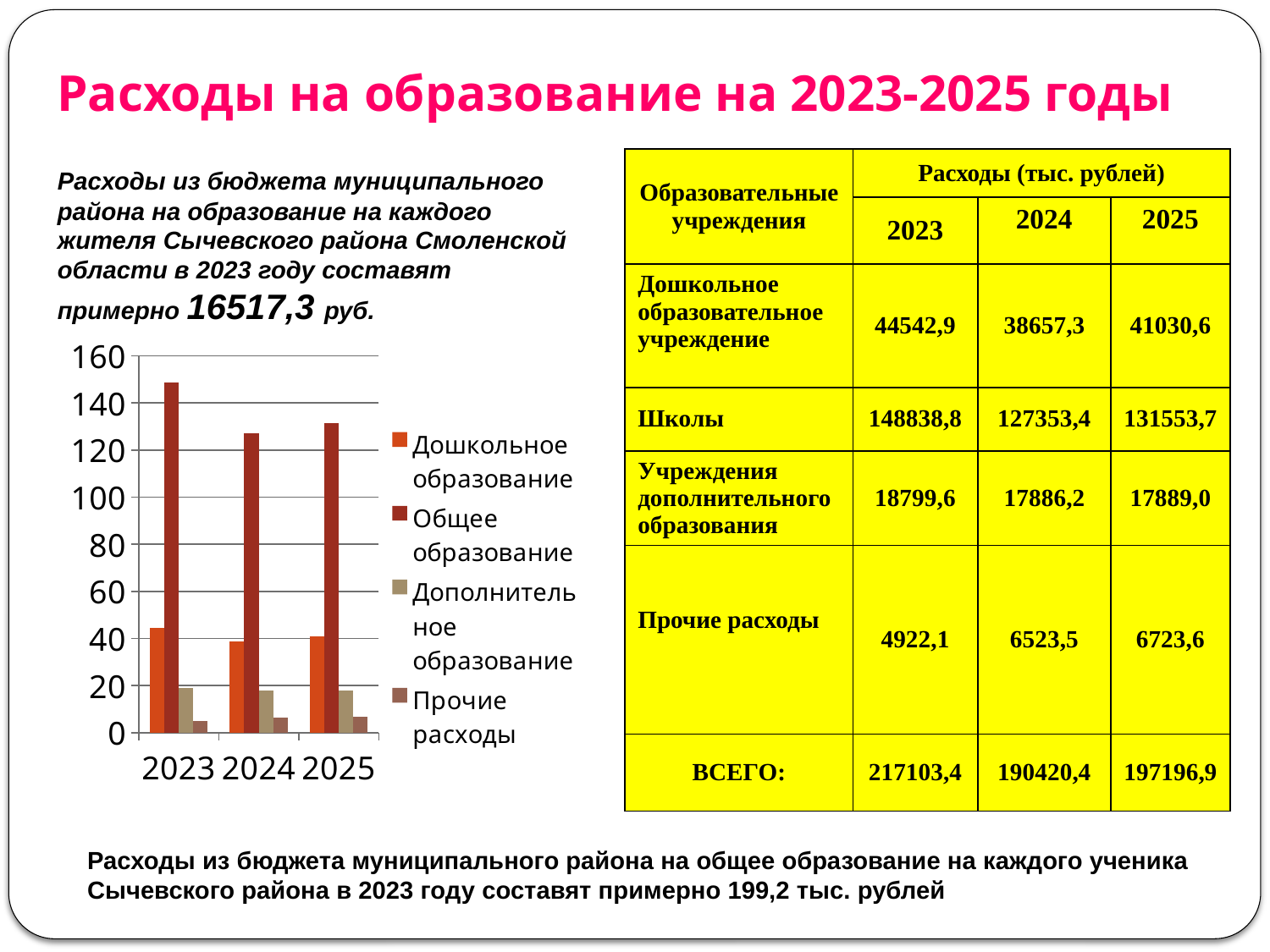
Is the value for Дошкольное образование in 2023 greater or less than 40? greater What kind of chart is shown on the slide? bar chart Which series has the tallest bar in 2023? Общее образование Which is larger: Общее образование in 2023 or Общее образование in 2024? 2023 What colour are the bars for Общее образование in the chart? dark red How many years are shown on the x axis of the chart? 3 Which series has the shortest bar in 2023? Прочие расходы How many series does the chart legend list? 4 Is the value for Общее образование in 2024 greater or less than 140? less Is the value for Общее образование in 2023 greater or less than 140? greater In which year is the bar for Общее образование the highest? 2023